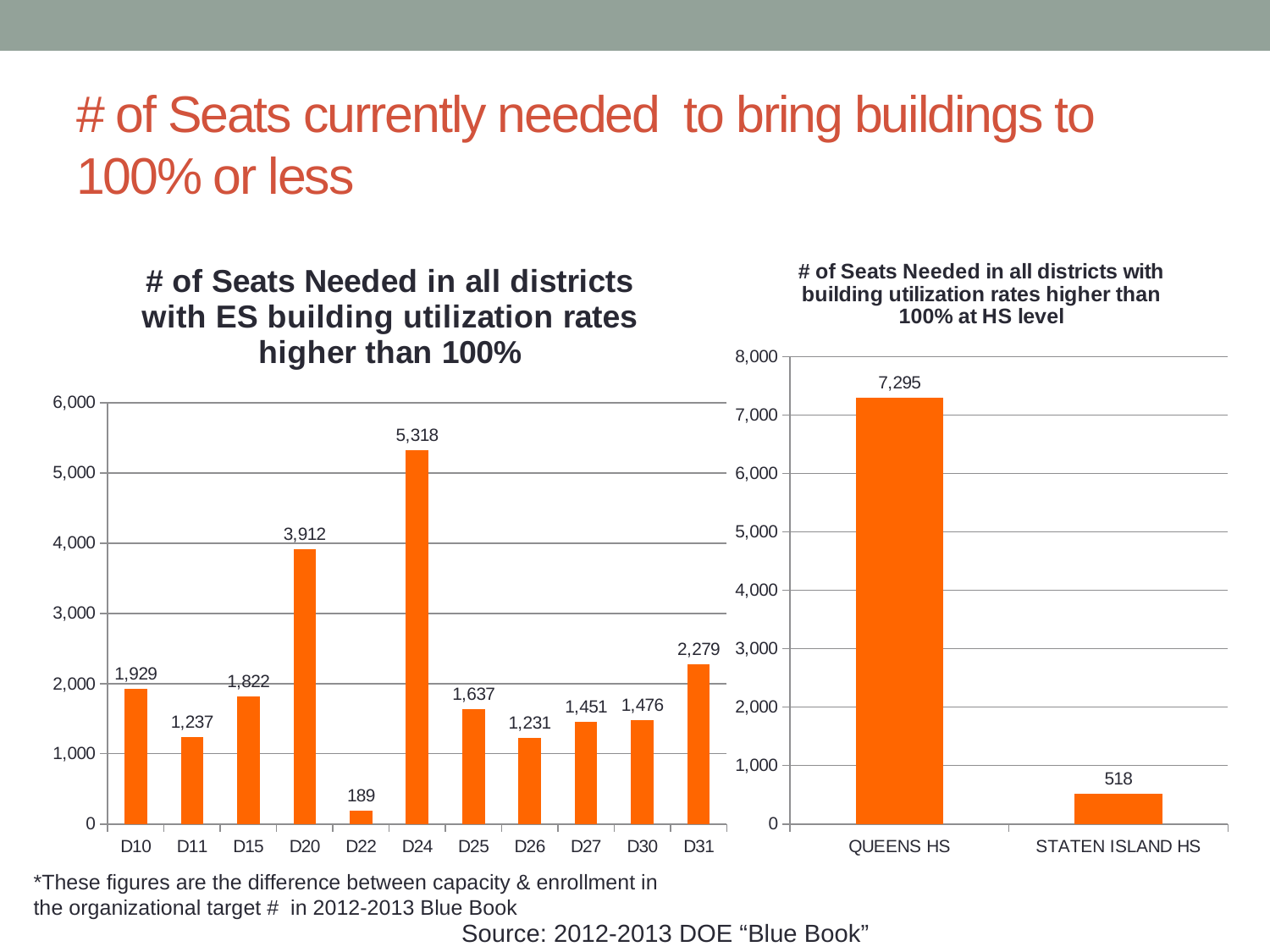
In the left chart (ES building utilization), how many seats are needed in D24? 5,318 In the left chart (ES building utilization), is the value for D20 greater or less than 4,000? less What is the title of the right chart? # of Seats Needed in all districts with building utilization rates higher than 100% at HS level In the left chart (ES building utilization), how many districts are shown on the x axis? 11 What type of chart is the right chart (HS level)? Bar chart In the left chart (ES building utilization), which district needs more seats, D10 or D15? D10 In the left chart (ES building utilization), which district has the highest number of seats needed? D24 In the left chart (ES building utilization), how many seats are needed in D22? 189 In the left chart (ES building utilization), which district has the lowest number of seats needed? D22 In the right chart (HS level), how many seats are needed for Queens HS? 7,295 In the left chart (ES building utilization), what is the difference in seats needed between D20 and D31? 1,633 In the right chart (HS level), what is the difference in seats needed between Queens HS and Staten Island HS? 6,777